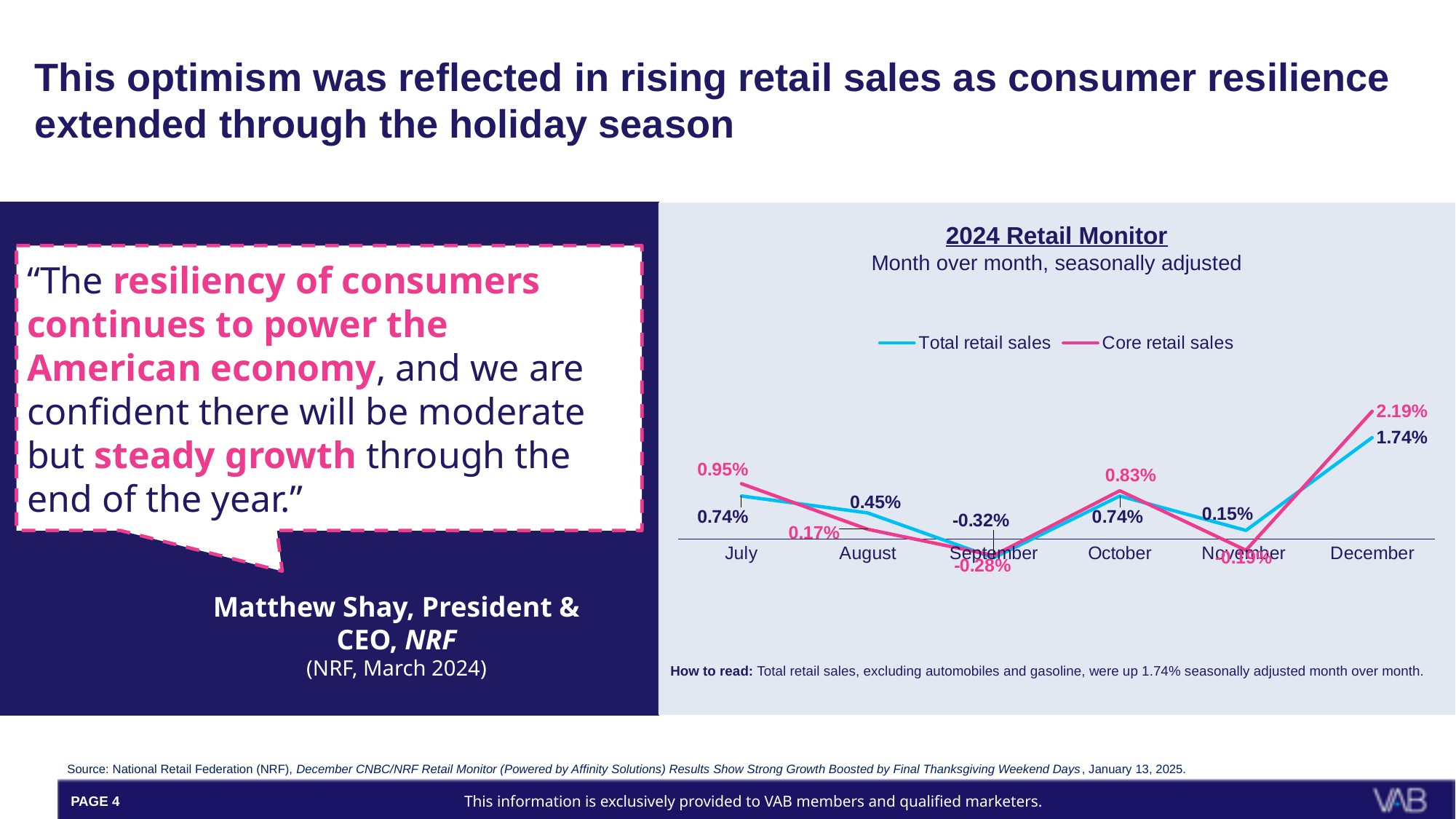
What is the value for Total retail sales in December? 1.74% How many months are plotted on the x axis of the chart? 6 What type of chart is shown on the slide? Line chart What is the difference between Core retail sales and Total retail sales in December? 0.45% In which month is Core retail sales highest? December What is the subtitle shown under the chart title '2024 Retail Monitor'? Month over month, seasonally adjusted Does Total retail sales rise or fall from July to September? Fall What is the value for Core retail sales in July? 0.95% How many series does the legend list in the 2024 Retail Monitor chart? 2 What is the value for Core retail sales in September? -0.28% In August, which series has the larger value, Total retail sales or Core retail sales? Total retail sales In which month is Total retail sales lowest? September